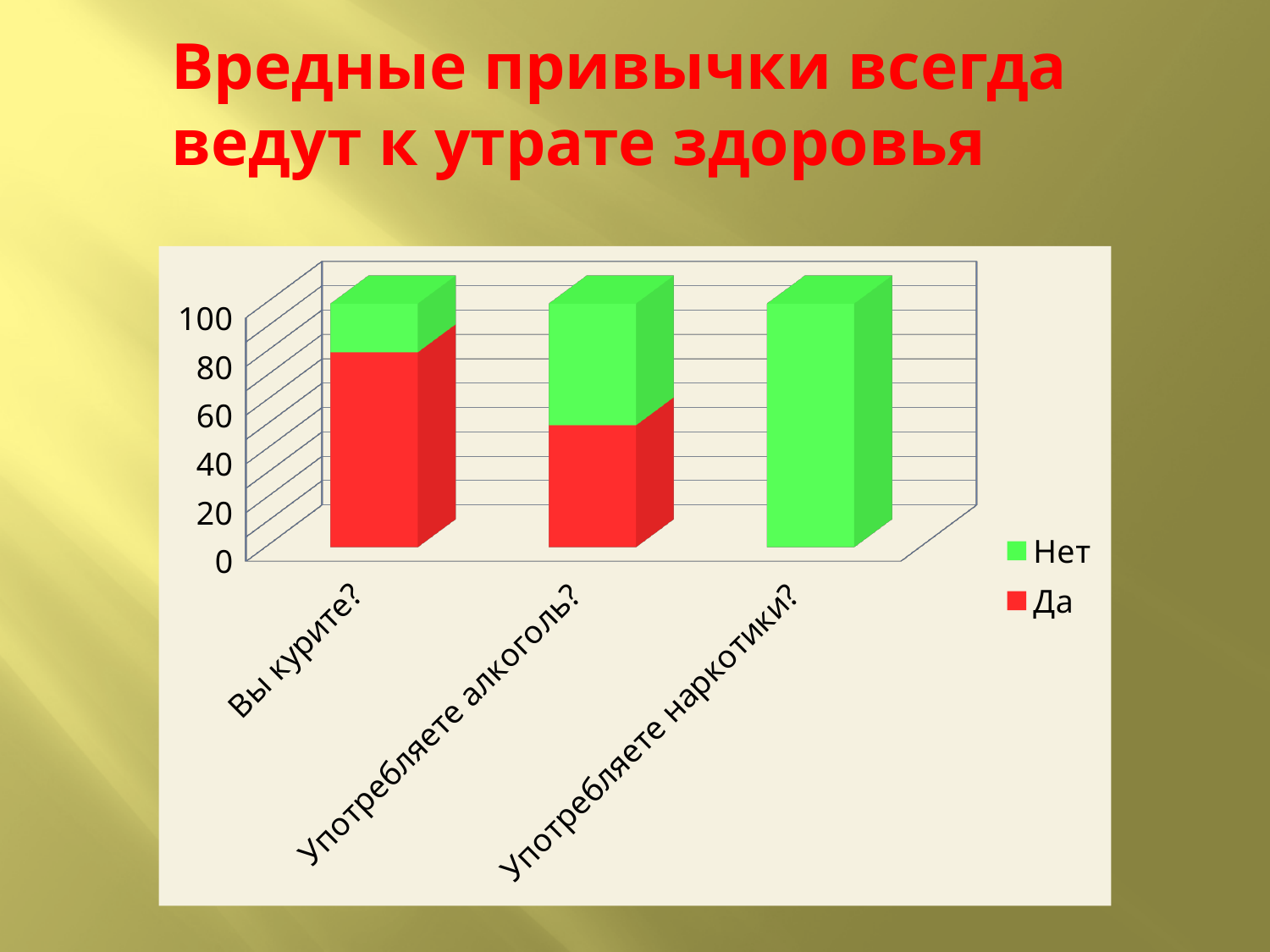
Which category has the largest green 'Нет' segment? Употребляете наркотики? How many series does the chart legend list? 2 Which is larger: the 'Да' value for 'Вы курите?' or the 'Да' value for 'Употребляете алкоголь?'? Вы курите? What kind of chart is shown on the slide? stacked bar chart Do the 'Да' values rise or fall moving from left to right across the categories? fall Is the 'Да' value for 'Употребляете алкоголь?' greater or less than 80? less Is the 'Нет' value for 'Употребляете наркотики?' greater or less than 80? greater Is the 'Да' value for 'Вы курите?' greater or less than 60? greater How many categories (questions) are shown along the x axis of the chart? 3 Which category has the smallest 'Да' value? Употребляете наркотики? Which category has the largest red 'Да' segment? Вы курите? Which colour represents the 'Да' series in the chart? red